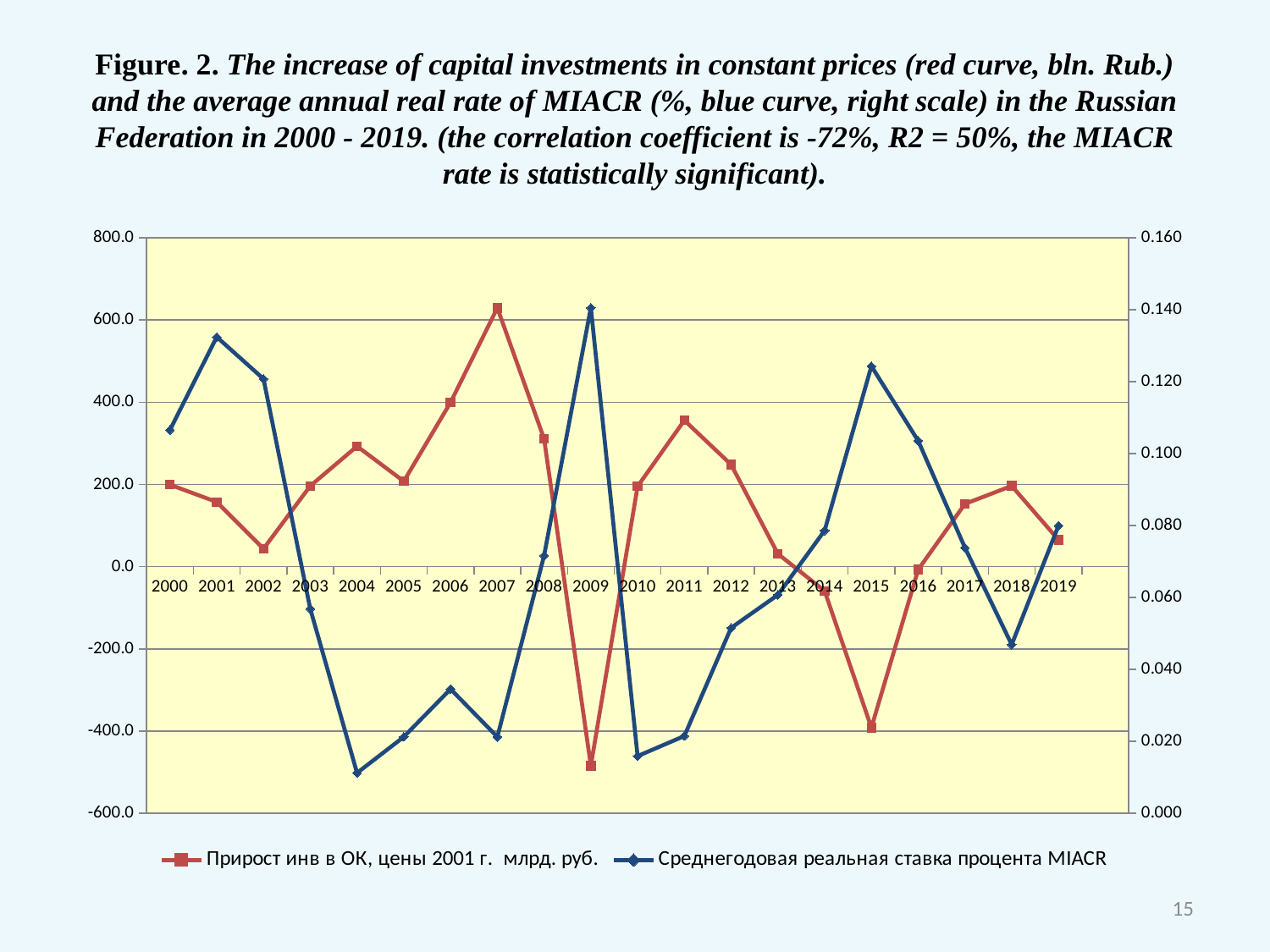
Does the blue curve (MIACR rate) rise or fall from 2001 to 2004? fall In which year does the red curve (increase of capital investments) reach its lowest value? 2009 What kind of chart is shown on the slide? line chart Is the value of the red curve (increase of capital investments) in 2015 greater or less than -200.0? less How many years are plotted along the x axis? 20 In which year does the red curve (increase of capital investments) reach its highest value? 2007 Which colour is used for the average annual real MIACR rate curve? blue Is the value of the blue curve (MIACR rate) in 2015 greater or less than 0.100? greater Is the value of the red curve (increase of capital investments) in 2011 greater or less than 200.0? greater Which year has the larger value on the red curve (increase of capital investments): 2007 or 2011? 2007 How many series does the legend list? 2